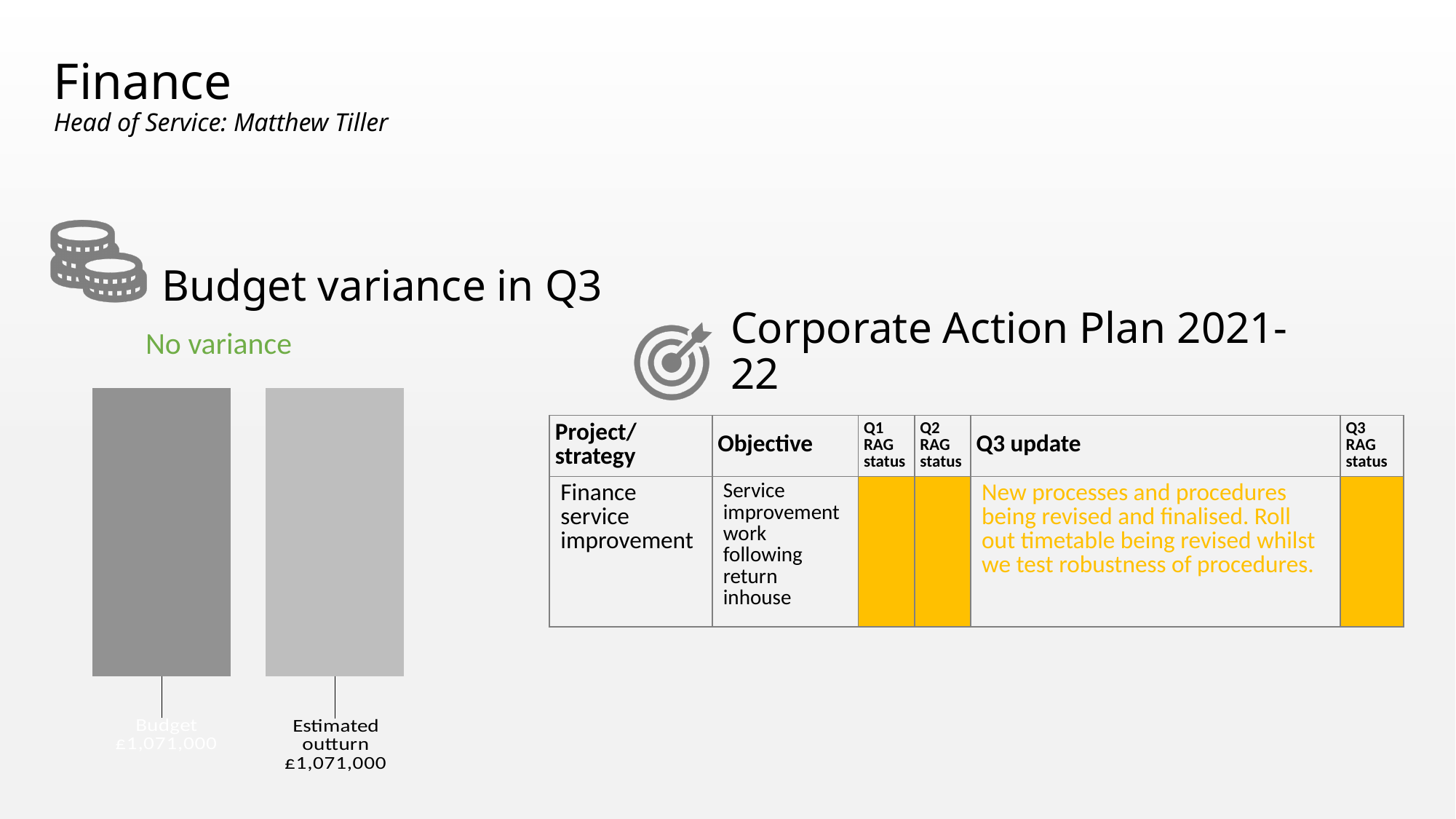
What is the value of the Budget bar in the Budget variance in Q3 chart? £1,071,000 What kind of chart is used to show the budget variance in Q3? Bar chart Is the Budget value in the Budget variance in Q3 chart greater or less than £1,000,000? greater What text in green appears above the Budget variance in Q3 chart? No variance What is the difference between the Budget and Estimated outturn values in the Budget variance in Q3 chart? £0 Is the Estimated outturn value in the Budget variance in Q3 chart greater or less than £1,000,000? greater How many bars are plotted in the Budget variance in Q3 chart? 2 What is the value of the Estimated outturn bar in the Budget variance in Q3 chart? £1,071,000 What are the two categories shown in the Budget variance in Q3 chart? Budget and Estimated outturn What is the title of the chart on the left of the slide? Budget variance in Q3